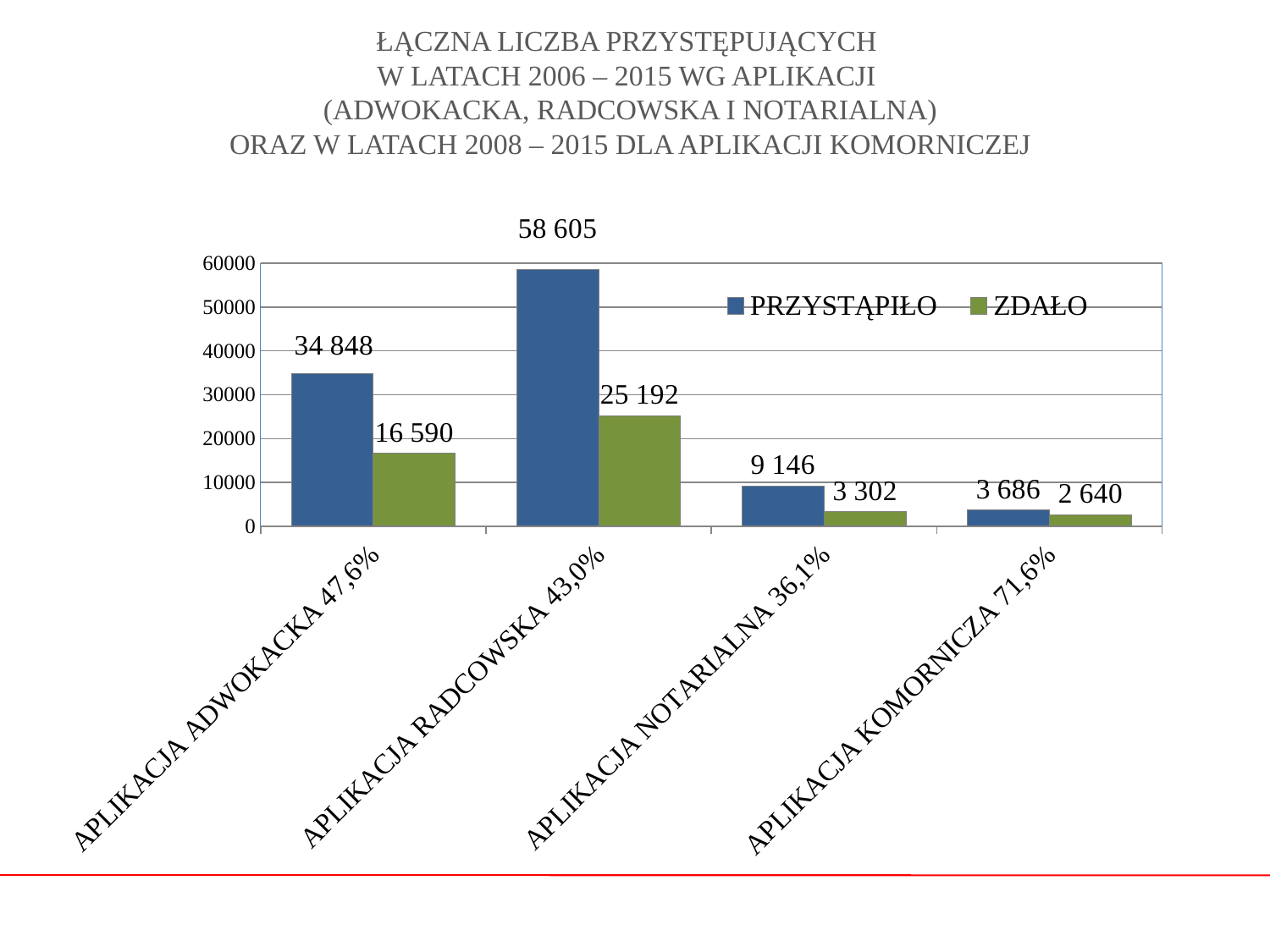
What is the ZDAŁO value for APLIKACJA KOMORNICZA 71,6%? 2 640 What is the difference between the PRZYSTĄPIŁO and ZDAŁO values for APLIKACJA ADWOKACKA 47,6%? 18 258 How many series does the legend list? 2 What is the PRZYSTĄPIŁO value for APLIKACJA NOTARIALNA 36,1%? 9 146 Which category has the lowest ZDAŁO value? APLIKACJA KOMORNICZA 71,6% What kind of chart is shown on the slide? bar chart What is the ZDAŁO value for APLIKACJA ADWOKACKA 47,6%? 16 590 What is the PRZYSTĄPIŁO value for APLIKACJA RADCOWSKA 43,0%? 58 605 Is the PRZYSTĄPIŁO value for APLIKACJA ADWOKACKA 47,6% greater or less than 30000? greater How many categories are shown on the x axis? 4 Which category has the highest PRZYSTĄPIŁO value? APLIKACJA RADCOWSKA 43,0% Which is larger: the ZDAŁO value for APLIKACJA NOTARIALNA 36,1% or the PRZYSTĄPIŁO value for APLIKACJA KOMORNICZA 71,6%? PRZYSTĄPIŁO value for APLIKACJA KOMORNICZA 71,6%